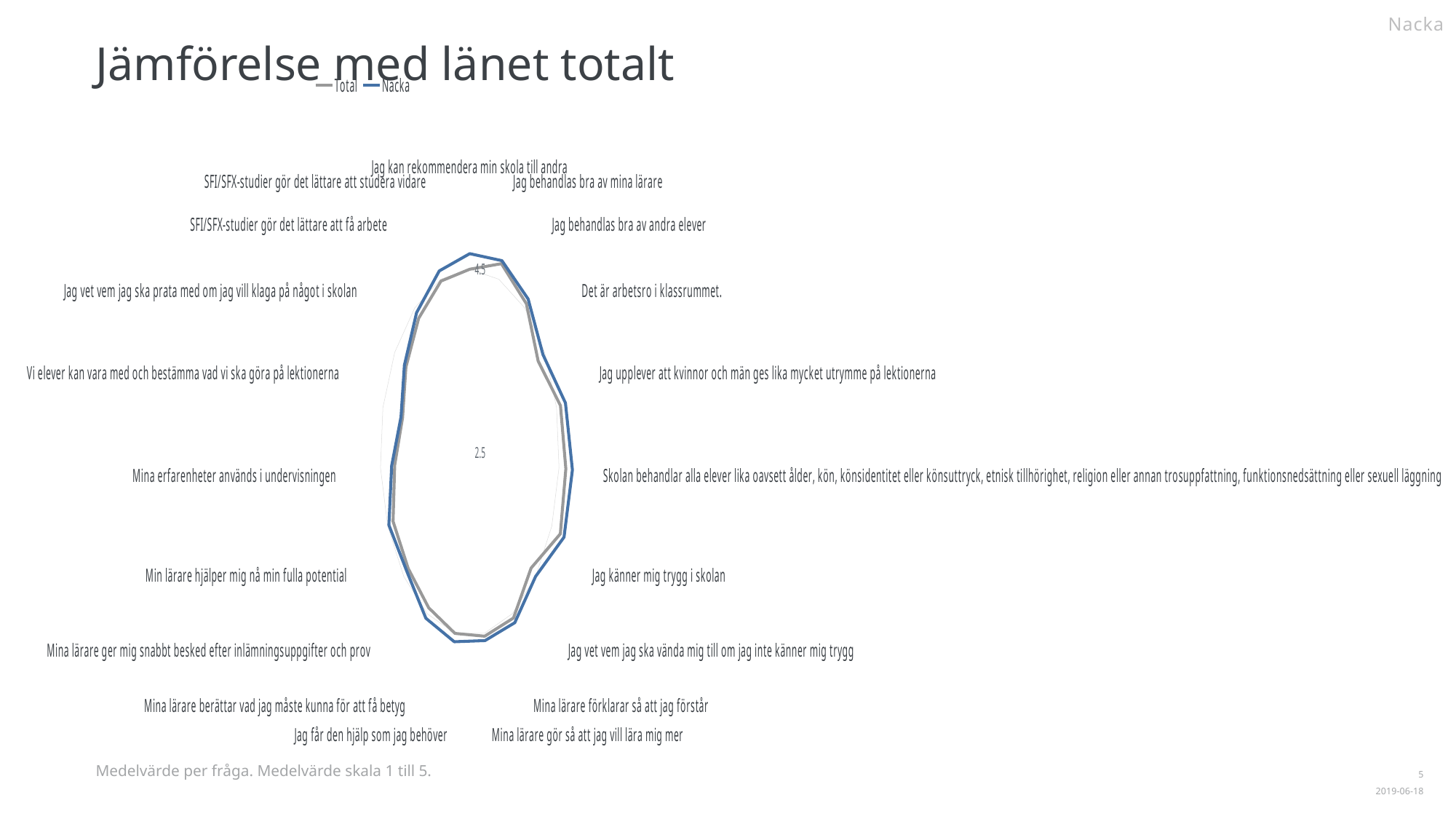
For 'Skolan behandlar alla elever lika oavsett ålder, kön, könsidentitet eller könsuttryck, etnisk tillhörighet, religion eller annan trosuppfattning, funktionsnedsättning eller sexuell läggning', which series has the larger value, Total or Nacka? Nacka How many series does the chart legend list? 2 How many categories (questions) are plotted around the radar chart? 19 Is the Nacka value for 'Mina lärare ger mig snabbt besked efter inlämningsuppgifter och prov' greater or less than 2.5? greater For 'Jag känner mig trygg i skolan', which series has the larger value, Total or Nacka? Nacka For 'Jag vet vem jag ska prata med om jag vill klaga på något i skolan', which series has the larger value, Total or Nacka? Nacka Which two series are listed in the chart legend? Total and Nacka What colour is the line for the Nacka series? Blue What kind of chart is shown on the slide? Radar chart Is the Total value for 'Jag känner mig trygg i skolan' greater or less than 2.5? greater Is the Nacka value for 'Jag kan rekommendera min skola till andra' greater or less than 2.5? greater